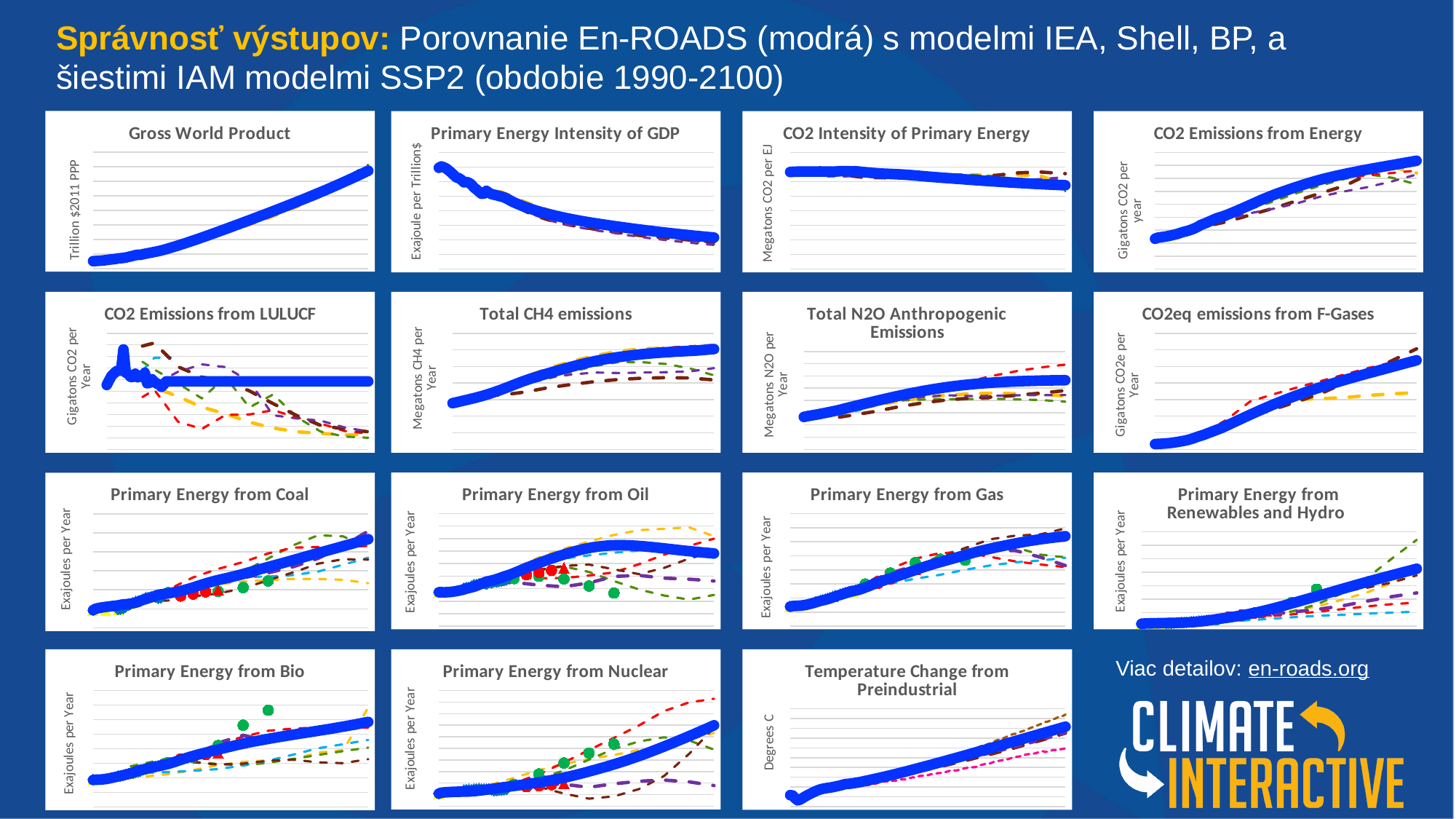
In the "Temperature Change from Preindustrial" chart, does the thick blue line rise or fall from left to right? rise In the "Primary Energy from Oil" chart, does the thick blue line rise or fall in the right-hand part of the chart after its peak? fall In the "CO2eq emissions from F-Gases" chart, does the thick blue line rise or fall from left to right? rise What kind of chart is the "Gross World Product" chart? line chart What is the y-axis label of the "Temperature Change from Preindustrial" chart? Degrees C What is the y-axis label of the "Gross World Product" chart? Trillion $2011 PPP